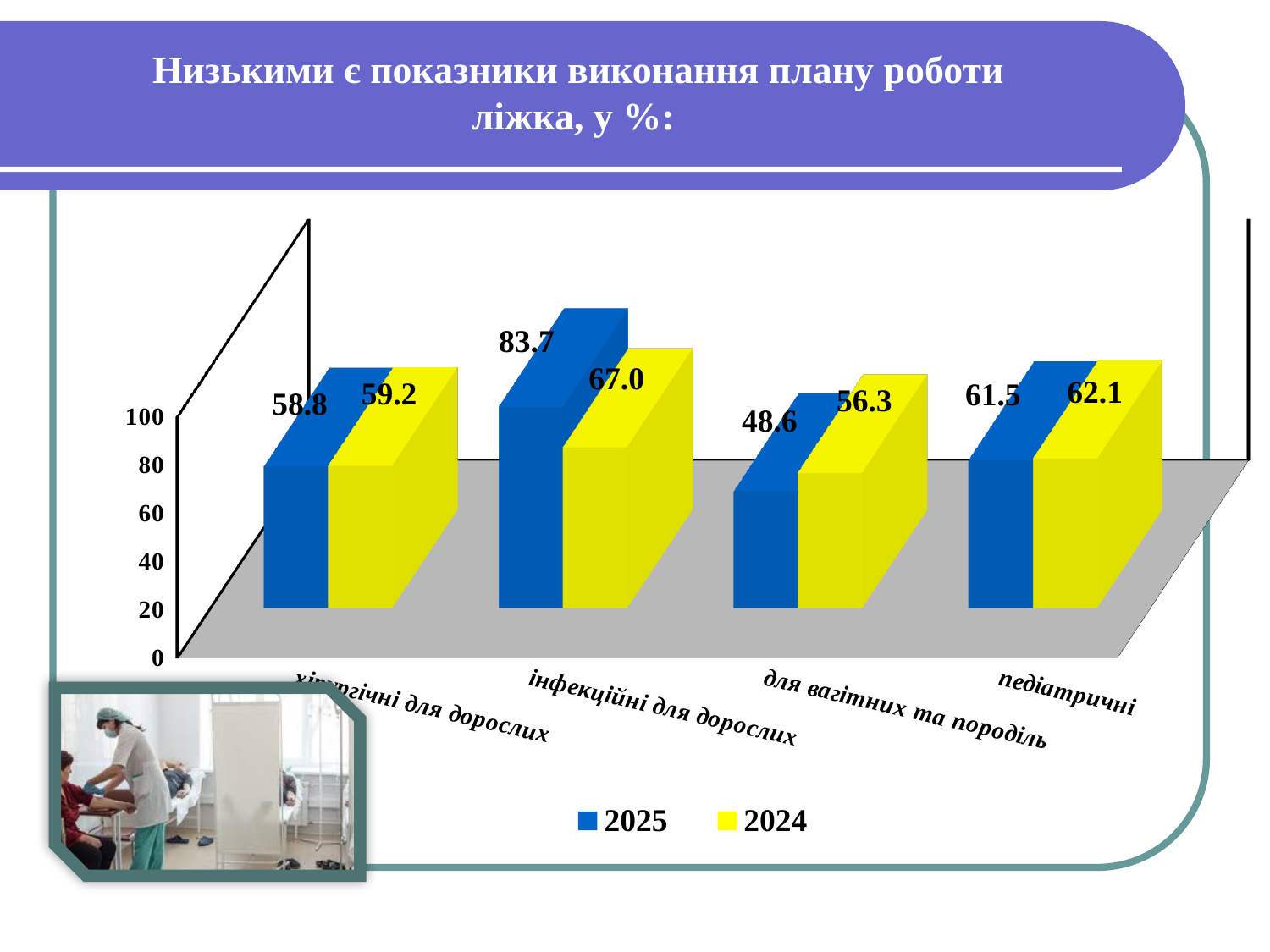
Which colour represents the 2024 series in the legend? yellow What is the value for для вагітних та породіль in the 2024 series? 56.3 What is the value for хірургічні для дорослих in the 2024 series? 59.2 How many categories are shown on the x axis? 4 For для вагітних та породіль, which series has the larger value, 2025 or 2024? 2024 How many series does the legend list? 2 What is the value for педіатричні in the 2025 series? 61.5 Which category has the lowest value in the 2025 series? для вагітних та породіль What is the difference between the 2025 and 2024 values for інфекційні для дорослих? 16.7 What kind of chart is shown on the slide? bar chart Which category has the highest value in the 2025 series? інфекційні для дорослих What is the value for інфекційні для дорослих in the 2025 series? 83.7